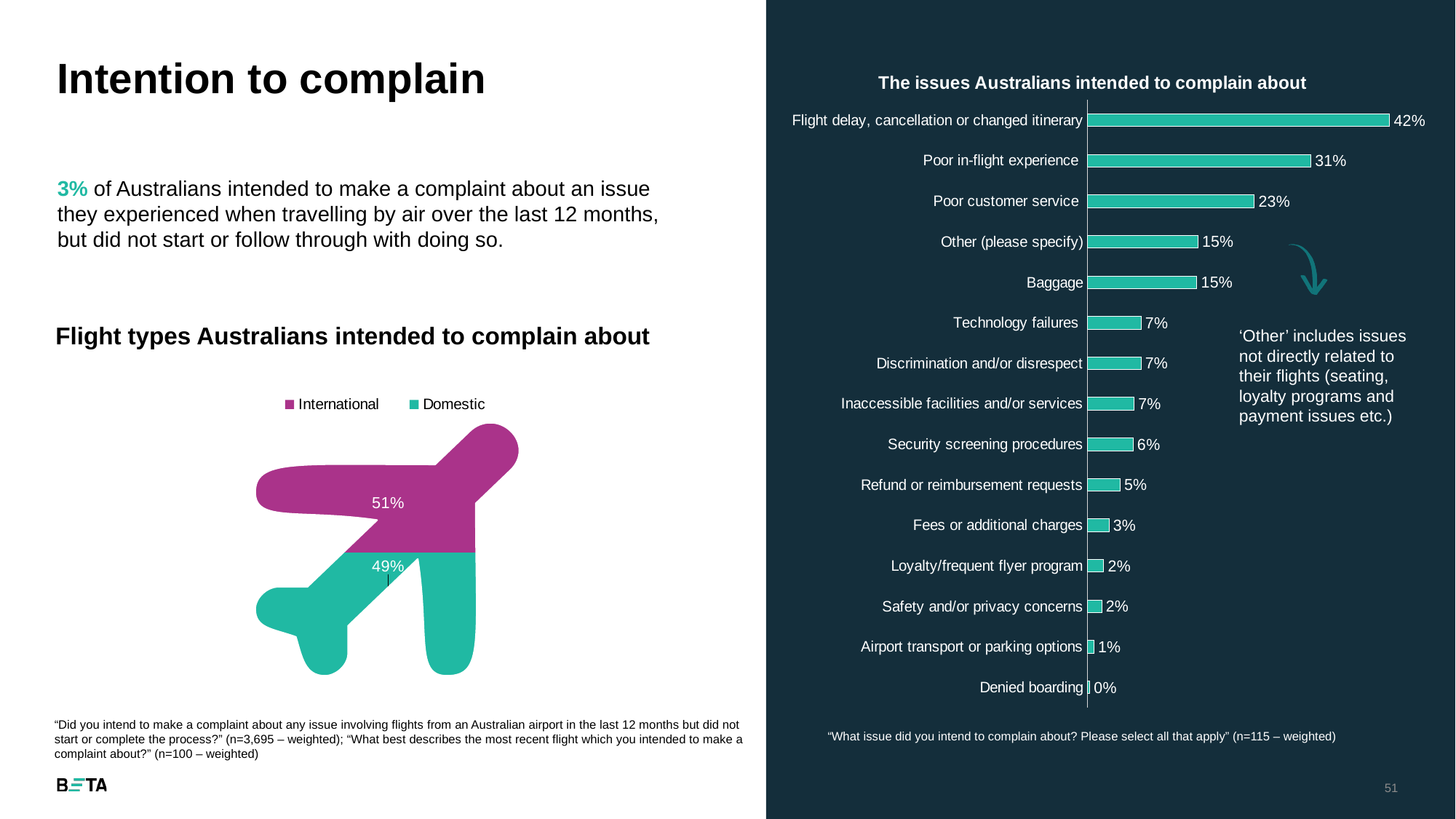
What kind of chart is 'The issues Australians intended to complain about'? Bar chart In the chart 'The issues Australians intended to complain about', what is the difference between Flight delay, cancellation or changed itinerary and Poor in-flight experience? 11% In the chart 'The issues Australians intended to complain about', which is larger: Baggage or Technology failures? Baggage In the chart 'Flight types Australians intended to complain about', what is the value for Domestic? 49% In the chart 'The issues Australians intended to complain about', what is the value for Poor customer service? 23% In the chart 'The issues Australians intended to complain about', what is the value for Security screening procedures? 6% How many issues are listed in the chart 'The issues Australians intended to complain about'? 15 In the chart 'The issues Australians intended to complain about', which issue has the highest value? Flight delay, cancellation or changed itinerary In the chart 'Flight types Australians intended to complain about', which colour represents International? Magenta/purple In the chart 'Flight types Australians intended to complain about', what is the value for International? 51% How many series does the legend of the chart 'Flight types Australians intended to complain about' list? 2 In the chart 'The issues Australians intended to complain about', which issue has the lowest value? Denied boarding